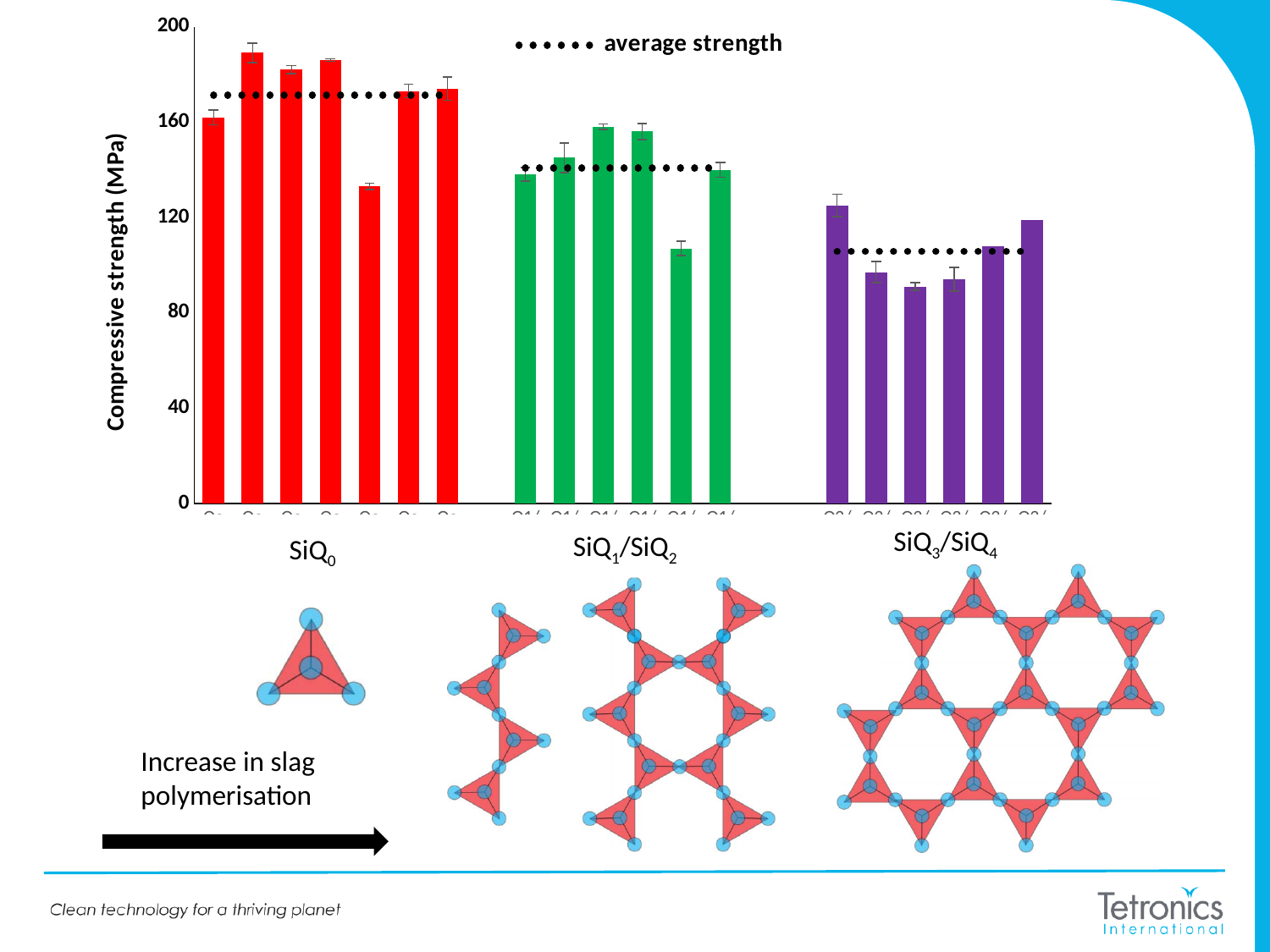
How many bars are in the SiQ1/SiQ2 group of the chart? 6 Which group has the lowest average strength line in the chart? SiQ3/SiQ4 Which group has the highest average strength line in the chart? SiQ0 How many bars are in the SiQ3/SiQ4 group of the chart? 6 What is the label of the y axis of the chart? Compressive strength (MPa) Is the average strength line for the SiQ0 group greater or less than 160? greater What kind of chart is shown on the slide? bar chart How many bars are in the SiQ0 group of the chart? 7 What does the dotted line in the chart represent, according to the legend? average strength Is the average strength line for the SiQ3/SiQ4 group greater or less than 120? less Is the average strength line for the SiQ1/SiQ2 group greater or less than 120? greater